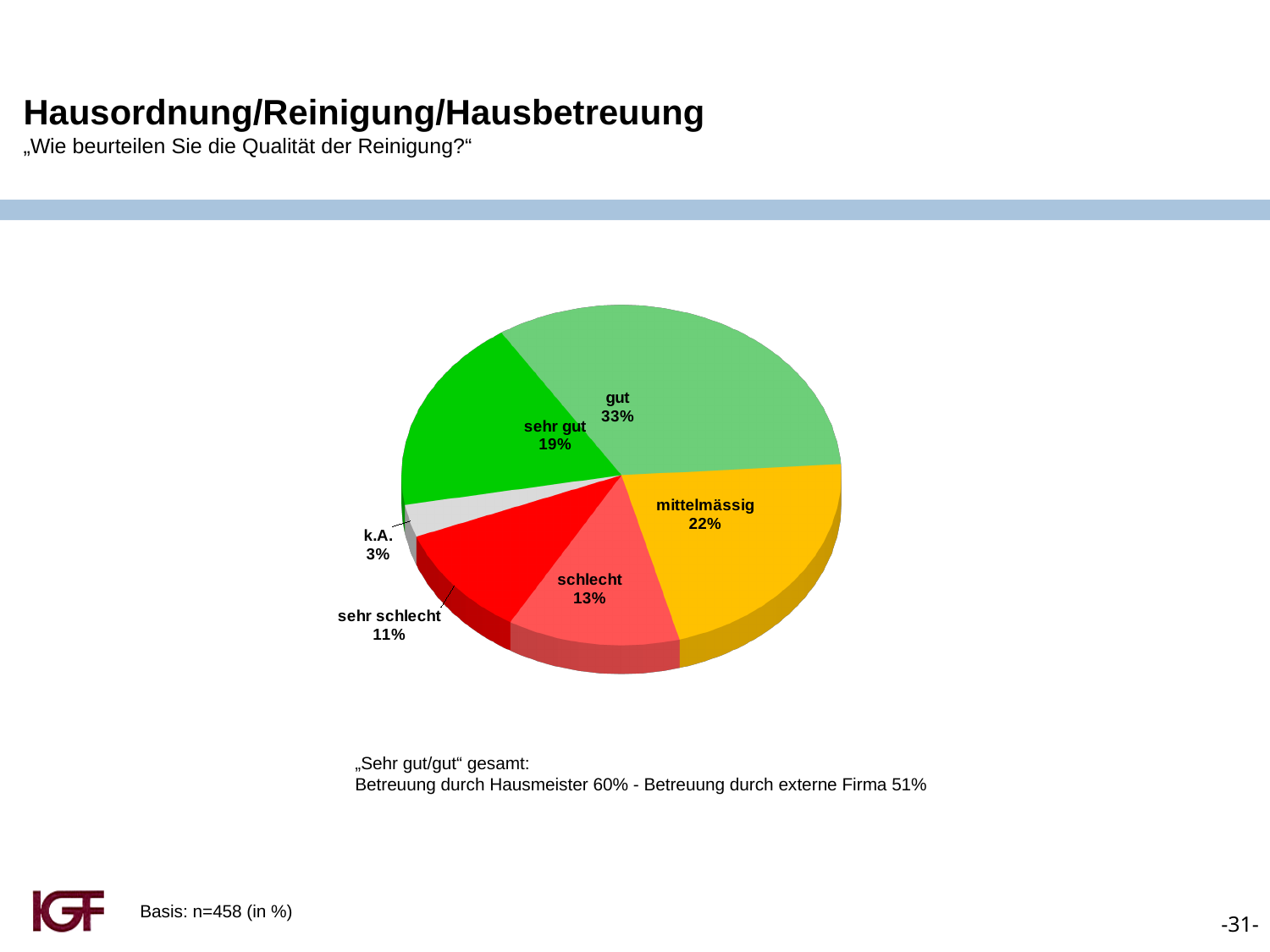
How many categories are shown in the pie chart? 6 What is the difference in percentage points between "gut" and "schlecht"? 20 What is the share for "sehr gut"? 19% What type of chart is shown on the slide? pie chart Which category has the largest slice of the pie? gut What is the value for "sehr schlecht"? 11% Which is larger, the share for "mittelmässig" or the share for "sehr gut"? mittelmässig What percentage of respondents rated the cleaning quality as "gut"? 33% What colour is the "mittelmässig" slice? yellow What percentage is labelled "k.A."? 3% What percentage is shown for "mittelmässig"? 22% Which category has the smallest slice of the pie? k.A.